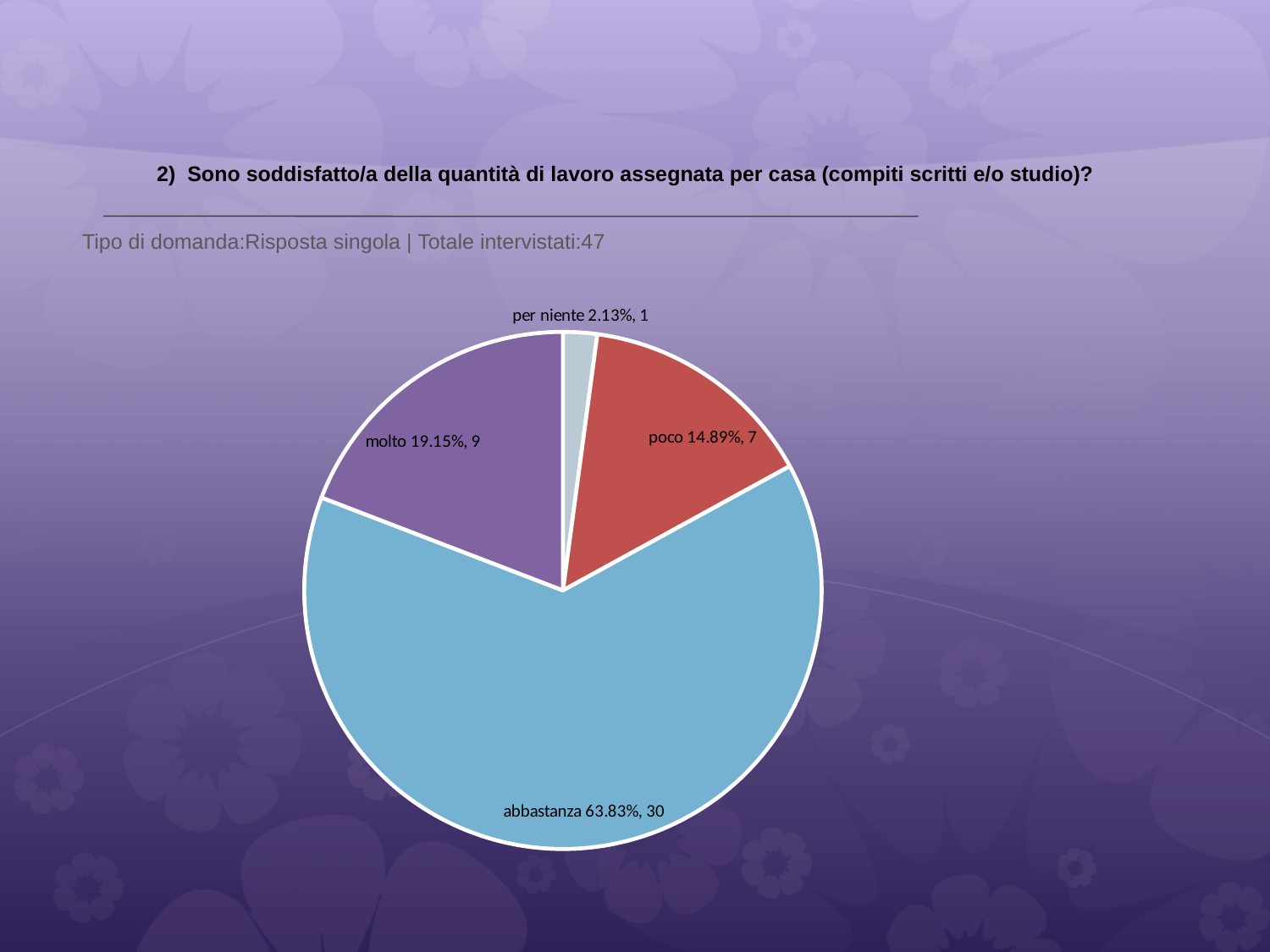
How many slices does the pie chart have? 4 What colour is the 'abbastanza' slice? light blue What percentage share does the 'abbastanza' slice have? 63.83% Which category has the smallest slice? per niente What is the total number of respondents across all slices? 47 How many respondents answered 'poco'? 7 What percentage share does the 'per niente' slice have? 2.13% Which has more respondents, 'molto' or 'poco'? molto What kind of chart is shown on the slide? pie chart How many respondents answered 'molto'? 9 Which category has the largest slice? abbastanza What is the difference in respondent count between 'abbastanza' and 'molto'? 21